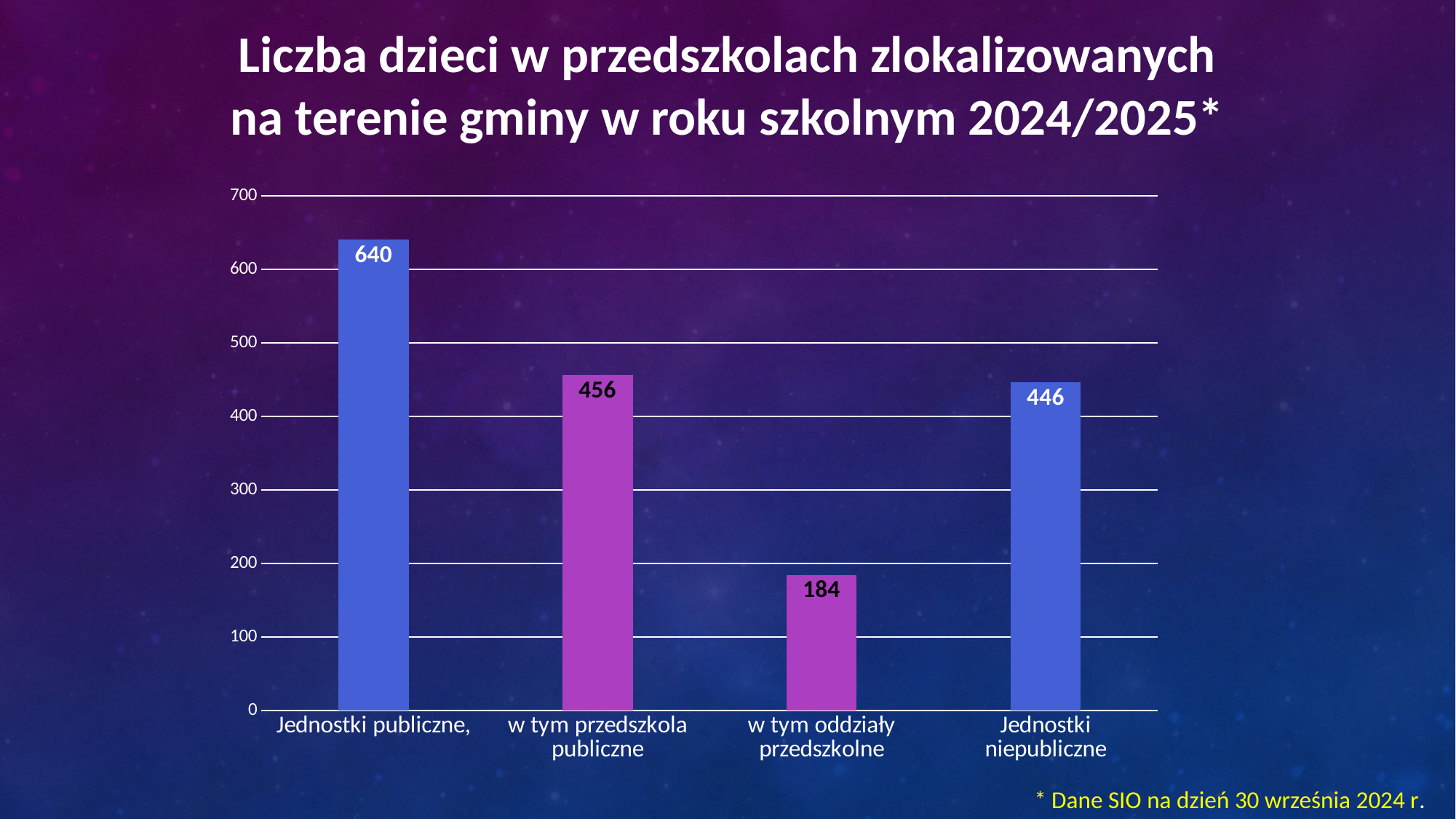
What is the difference between the values for w tym przedszkola publiczne and w tym oddziały przedszkolne? 272 What is the value for w tym oddziały przedszkolne? 184 Which category has the lowest value? w tym oddziały przedszkolne Which category has the highest value? Jednostki publiczne Which is larger: the value for w tym przedszkola publiczne or the value for Jednostki niepubliczne? w tym przedszkola publiczne What is the highest value shown on the vertical axis? 700 What kind of chart is shown on the slide? bar chart What is the value for Jednostki niepubliczne? 446 How many categories are shown on the chart? 4 What is the value for Jednostki publiczne? 640 What is the value for w tym przedszkola publiczne? 456 What is the difference between the values for Jednostki publiczne and Jednostki niepubliczne? 194